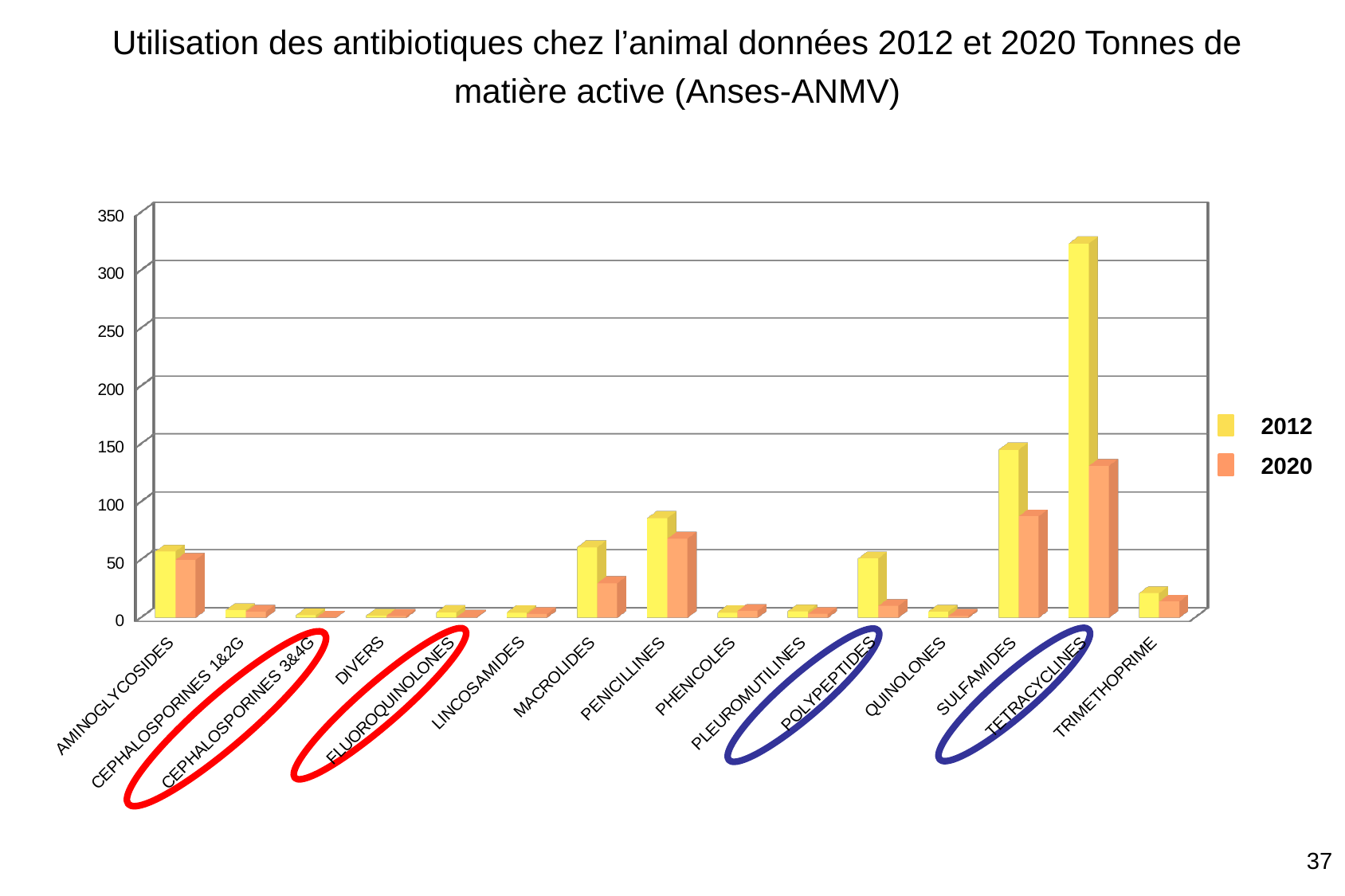
For 2012, which is larger, SULFAMIDES or PENICILLINES? SULFAMIDES Which category has the highest value for 2012? TETRACYCLINES Is the 2020 value for MACROLIDES greater or less than 50? less Is the 2012 value for TETRACYCLINES greater or less than 300? greater Is the 2012 value for PENICILLINES greater or less than 100? less Which category has the highest value for 2020? TETRACYCLINES How many antibiotic categories are shown on the x axis? 15 How many series does the legend list? 2 For TETRACYCLINES, which year has the larger value, 2012 or 2020? 2012 What kind of chart is shown on the slide? bar chart Which two years are shown in the legend? 2012 and 2020